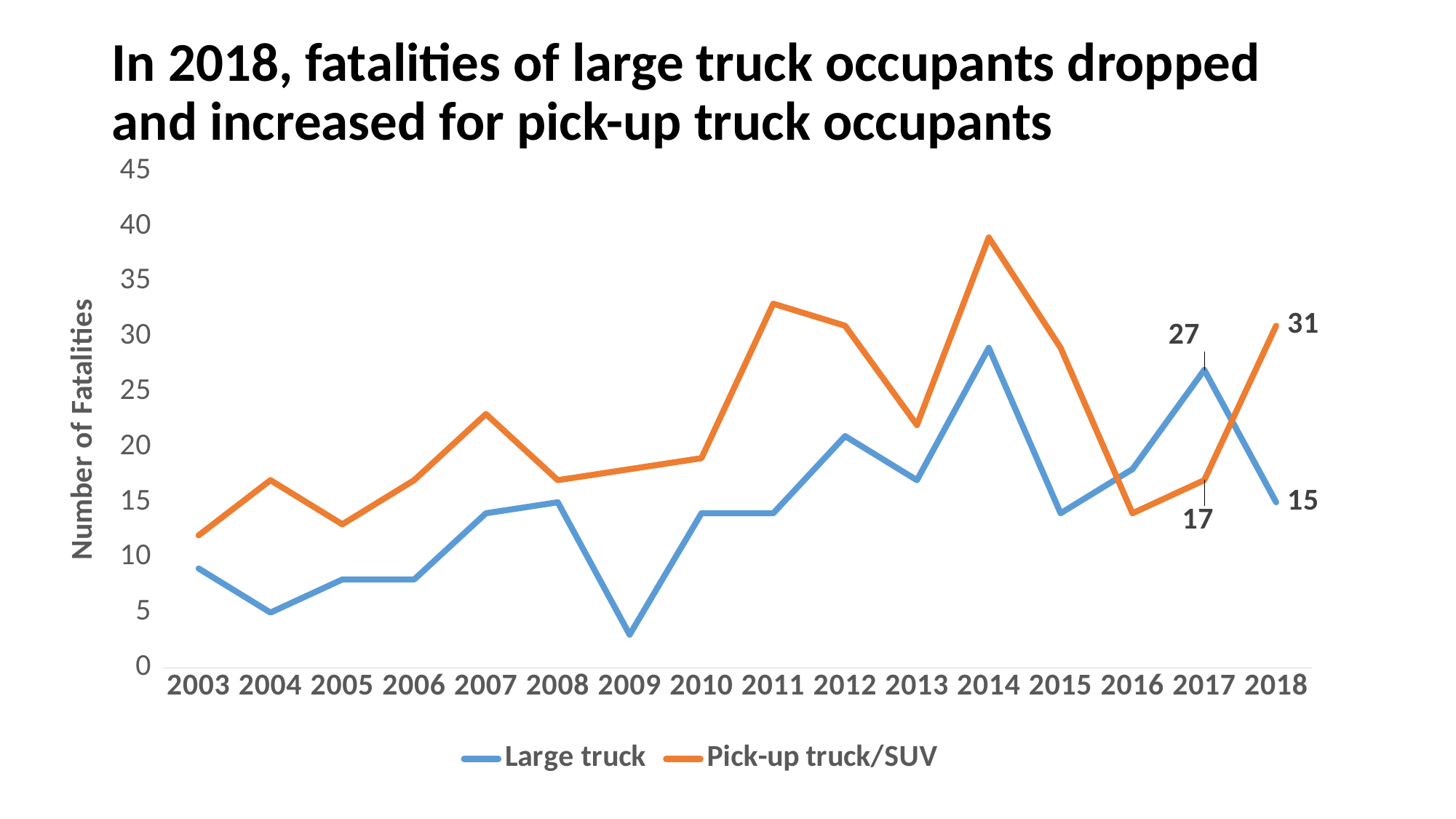
What is the value for Pick-up truck/SUV in 2017? 17 By how much did the Large truck value change from 2017 to 2018? 12 In which year does the Large truck series reach its lowest value? 2009 What kind of chart is shown on the slide? line chart In 2018, which series has the larger value, Large truck or Pick-up truck/SUV? Pick-up truck/SUV What is the difference between the Pick-up truck/SUV and Large truck values in 2018? 16 What is the value for Pick-up truck/SUV in 2018? 31 Is the value for Pick-up truck/SUV in 2014 greater or less than 35? greater How many years are shown on the x axis? 16 What is the value for Large truck in 2017? 27 What is the value for Large truck in 2018? 15 In which year does the Pick-up truck/SUV series reach its highest value? 2014